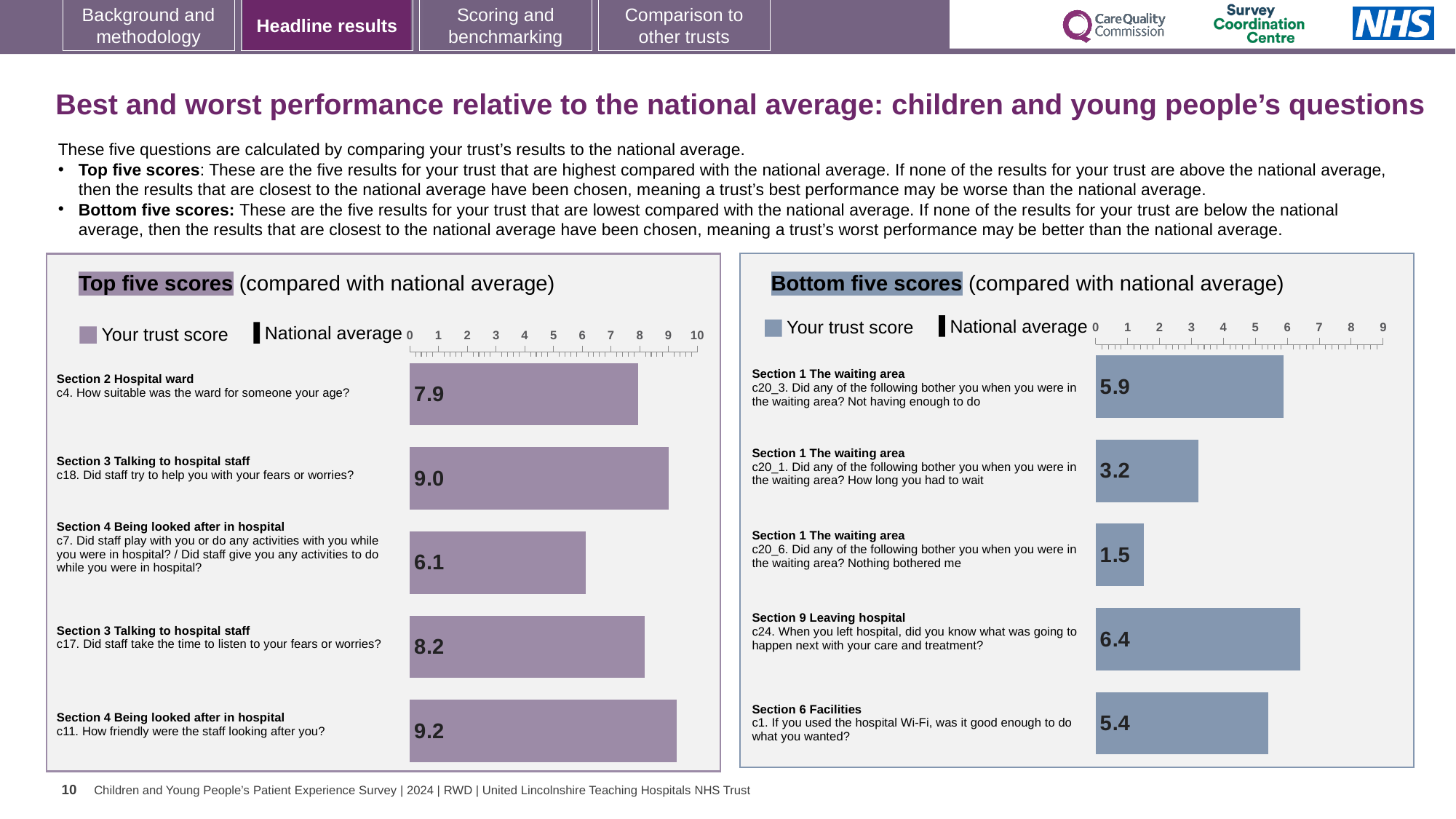
In the Top five scores chart, which question has the lowest trust score? c7. Did staff play with you or do any activities with you while you were in hospital? / Did staff give you any activities to do while you were in hospital? In the Bottom five scores chart, which question has the highest trust score? c24. When you left hospital, did you know what was going to happen next with your care and treatment? In the Top five scores chart, how many questions are plotted? 5 In the Top five scores chart, what is the difference between the trust scores for c18 and c17? 0.8 In the Bottom five scores chart, which question has the lowest trust score? c20_6. Did any of the following bother you when you were in the waiting area? Nothing bothered me In the Bottom five scores chart, what is the difference between the trust scores for c20_3 and c1? 0.5 What type of chart is the Bottom five scores chart? Bar chart In the Top five scores chart, what is the trust score for c11. How friendly were the staff looking after you? 9.2 In the Bottom five scores chart, what is the trust score for c20_1. How long you had to wait? 3.2 In the Bottom five scores chart, which has the larger trust score: c20_3 (Not having enough to do) or c1 (hospital Wi-Fi)? c20_3 (Not having enough to do) In the Top five scores chart, what is the trust score for c4. How suitable was the ward for someone your age? 7.9 How many series does the legend of the Top five scores chart list? 2